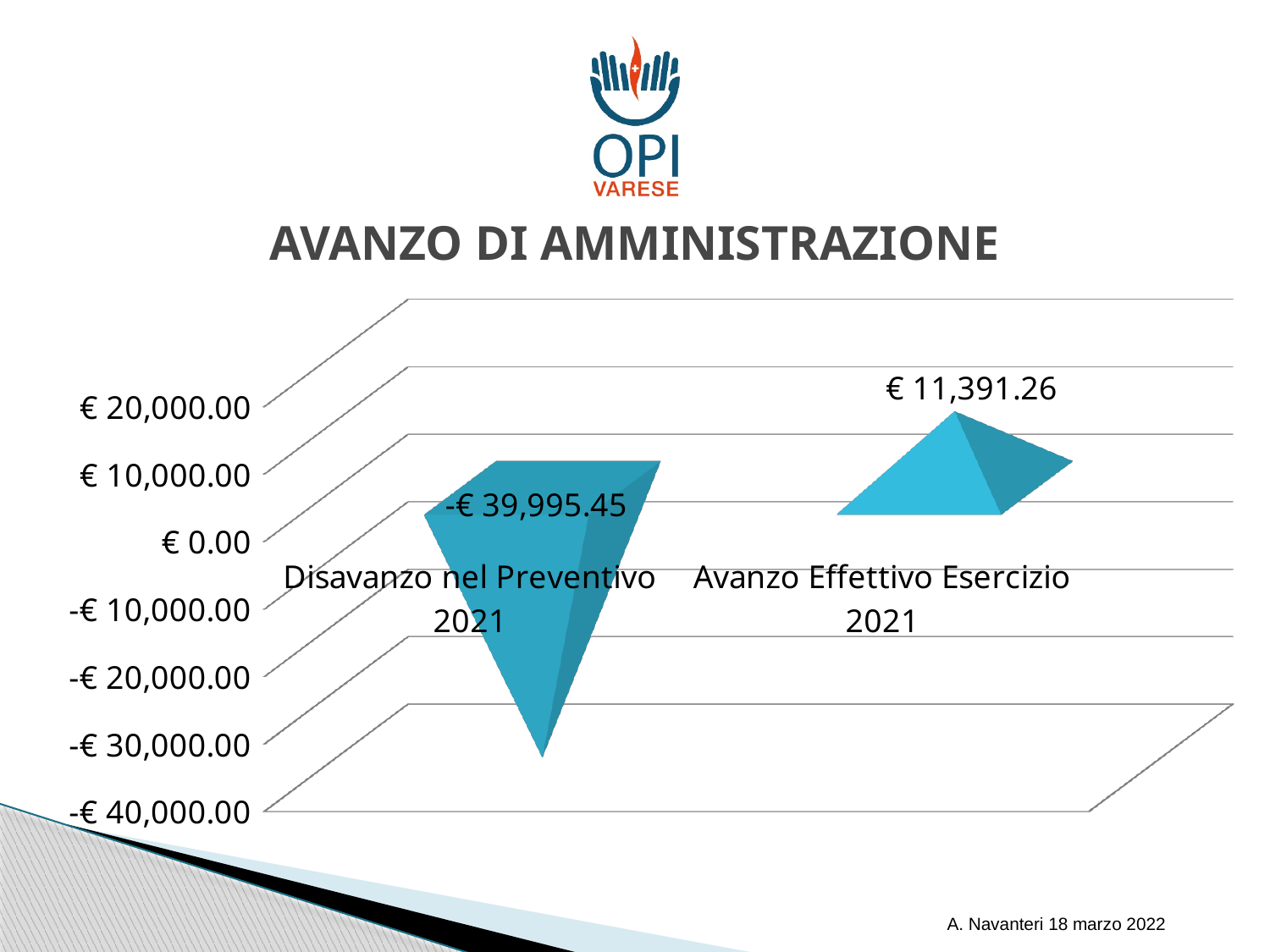
What is the value for Disavanzo nel Preventivo 2021? -€ 39,995.45 How many categories are plotted in the chart? 2 What is the title of the chart? AVANZO DI AMMINISTRAZIONE Which category has the lowest value? Disavanzo nel Preventivo 2021 Which is larger, the value for Disavanzo nel Preventivo 2021 or the value for Avanzo Effettivo Esercizio 2021? Avanzo Effettivo Esercizio 2021 Is the value for Avanzo Effettivo Esercizio 2021 greater or less than € 10,000.00? greater What is the lowest value shown on the vertical axis? -€ 40,000.00 Is the value for Disavanzo nel Preventivo 2021 greater or less than -€ 30,000.00? less What is the value for Avanzo Effettivo Esercizio 2021? € 11,391.26 Which category has the highest value? Avanzo Effettivo Esercizio 2021 What is the difference between the value for Avanzo Effettivo Esercizio 2021 and the value for Disavanzo nel Preventivo 2021? € 51,386.71 What kind of chart is shown on the slide? bar chart